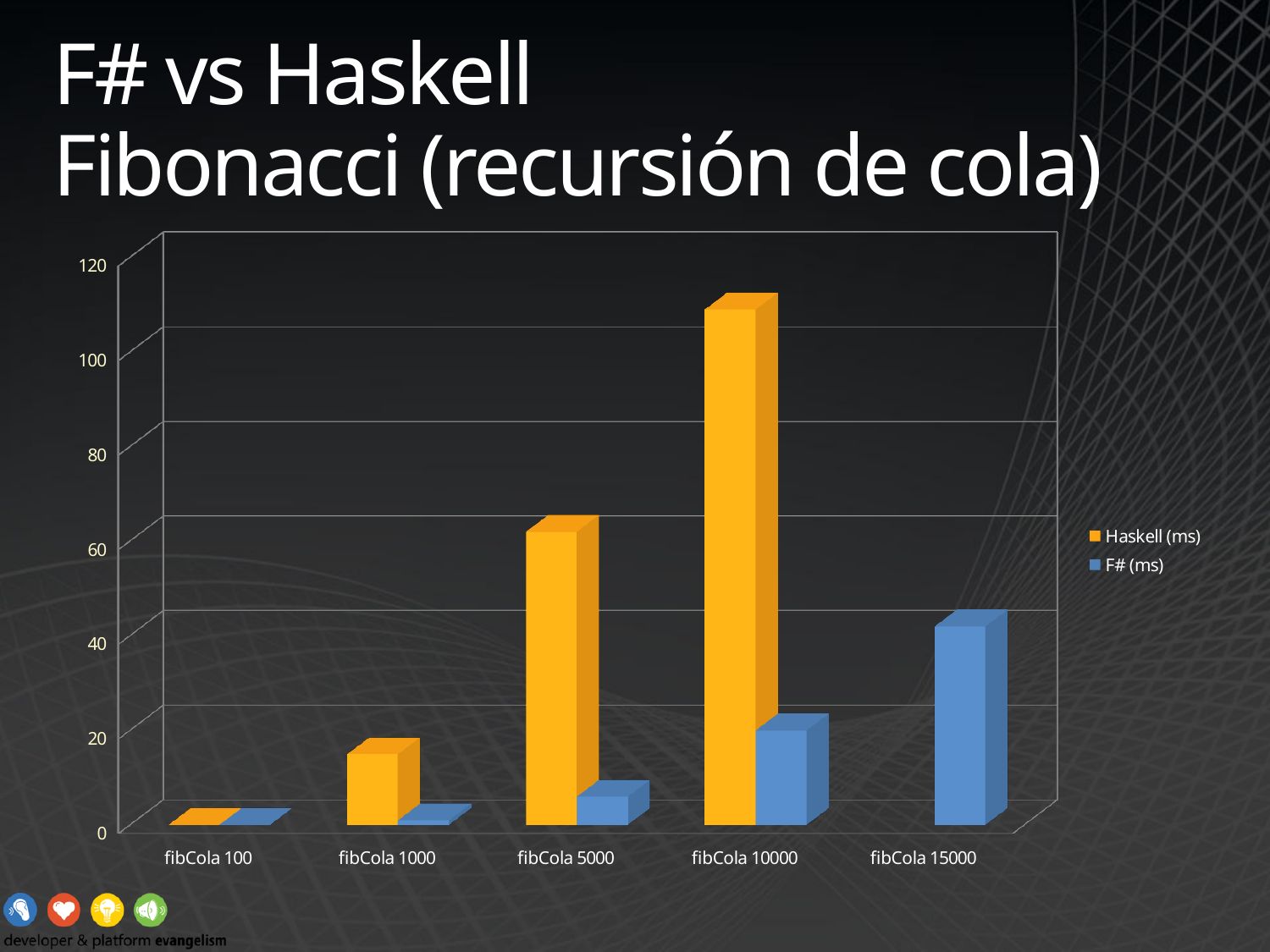
How many series does the chart's legend list? 2 For fibCola 5000, which is larger: the Haskell (ms) value or the F# (ms) value? Haskell (ms) Is the Haskell (ms) value for fibCola 5000 greater or less than 40? greater Which colour represents the Haskell (ms) series in the chart? orange Is the F# (ms) value for fibCola 15000 greater or less than 60? less What kind of chart is shown on the slide? bar chart Is the Haskell (ms) value for fibCola 10000 greater or less than 100? greater Do the F# (ms) values rise or fall from fibCola 100 to fibCola 15000? rise Which category has the highest Haskell (ms) value? fibCola 10000 Which category has the highest F# (ms) value? fibCola 15000 How many categories are shown on the x axis of the chart? 5